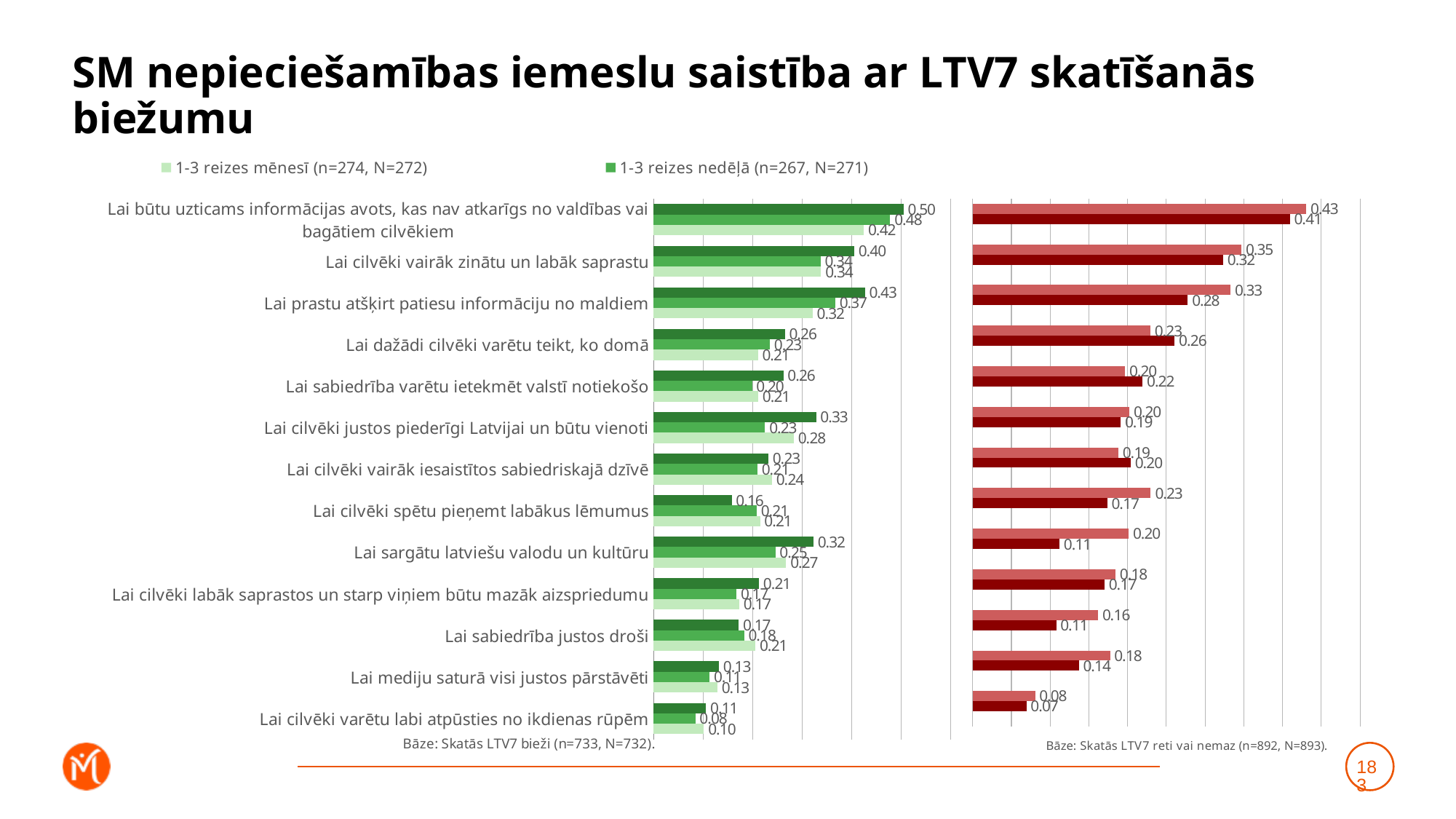
In the left (green) chart, which category has the highest value for the '1-3 reizes nedēļā' series? Lai būtu uzticams informācijas avots, kas nav atkarīgs no valdības vai bagātiem cilvēkiem What base note is printed under the right (red) chart? Bāze: Skatās LTV7 reti vai nemaz (n=892, N=893). In the left (green) chart, for 'Lai sargātu latviešu valodu un kultūru', which series has the larger value: '1-3 reizes mēnesī' or '1-3 reizes nedēļā'? 1-3 reizes mēnesī In the left (green) chart, for 'Lai cilvēki justos piederīgi Latvijai un būtu vienoti', how much larger is the '1-3 reizes mēnesī' value than the '1-3 reizes nedēļā' value? 0,05 In the left (green) chart, what is the value of the '1-3 reizes mēnesī' series for 'Lai būtu uzticams informācijas avots, kas nav atkarīgs no valdības vai bagātiem cilvēkiem'? 0,42 How many categories (reasons) are listed in the left (green) chart? 13 In the left (green) chart, which category has the lowest value for the '1-3 reizes mēnesī' series? Lai cilvēki varētu labi atpūsties no ikdienas rūpēm What type of chart is used on this slide? Bar chart How many series does the legend at the top of the slide list? 2 In the right (red) chart, which category has the lowest value for the lower, darker red bar? Lai cilvēki varētu labi atpūsties no ikdienas rūpēm In the left (green) chart, what is the value of the '1-3 reizes nedēļā' series for 'Lai prastu atšķirt patiesu informāciju no maldiem'? 0,37 In the right (red) chart, what is the value of the upper, lighter red bar for 'Lai cilvēki spētu pieņemt labākus lēmumus'? 0,23